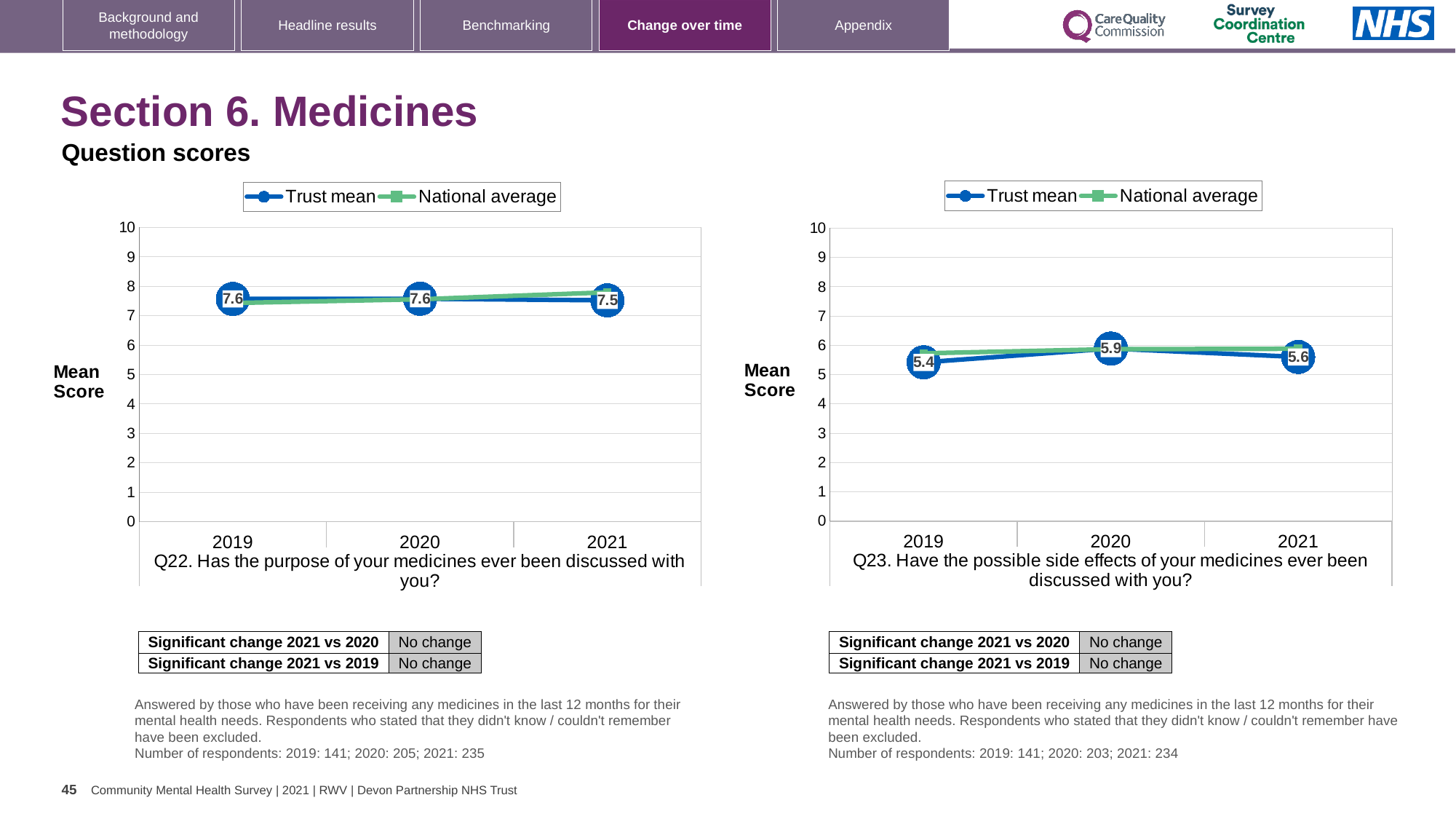
On the Q23 chart (right), which year has the lowest Trust mean score? 2019 How many years are shown on the x axis of the Q23 chart (right)? 3 On the Q23 chart (right), what is the Trust mean score for 2019? 5.4 On the Q22 chart (left), what is the Trust mean score for 2021? 7.5 On the Q23 chart (right), what is the difference between the Trust mean scores for 2020 and 2019? 0.5 On the Q22 chart (left), is the Trust mean score for 2020 larger or smaller than the Trust mean score for 2021? larger On the Q23 chart (right), which year has the highest Trust mean score? 2020 On the Q23 chart (right), what is the Trust mean score for 2020? 5.9 What type of chart is used for the Q23 chart (right)? Line chart How many series does the legend of the Q22 chart (left) list? 2 On the Q22 chart (left), what is the Trust mean score for 2019? 7.6 On the Q22 chart (left), is the National average for 2021 greater or less than 7? greater